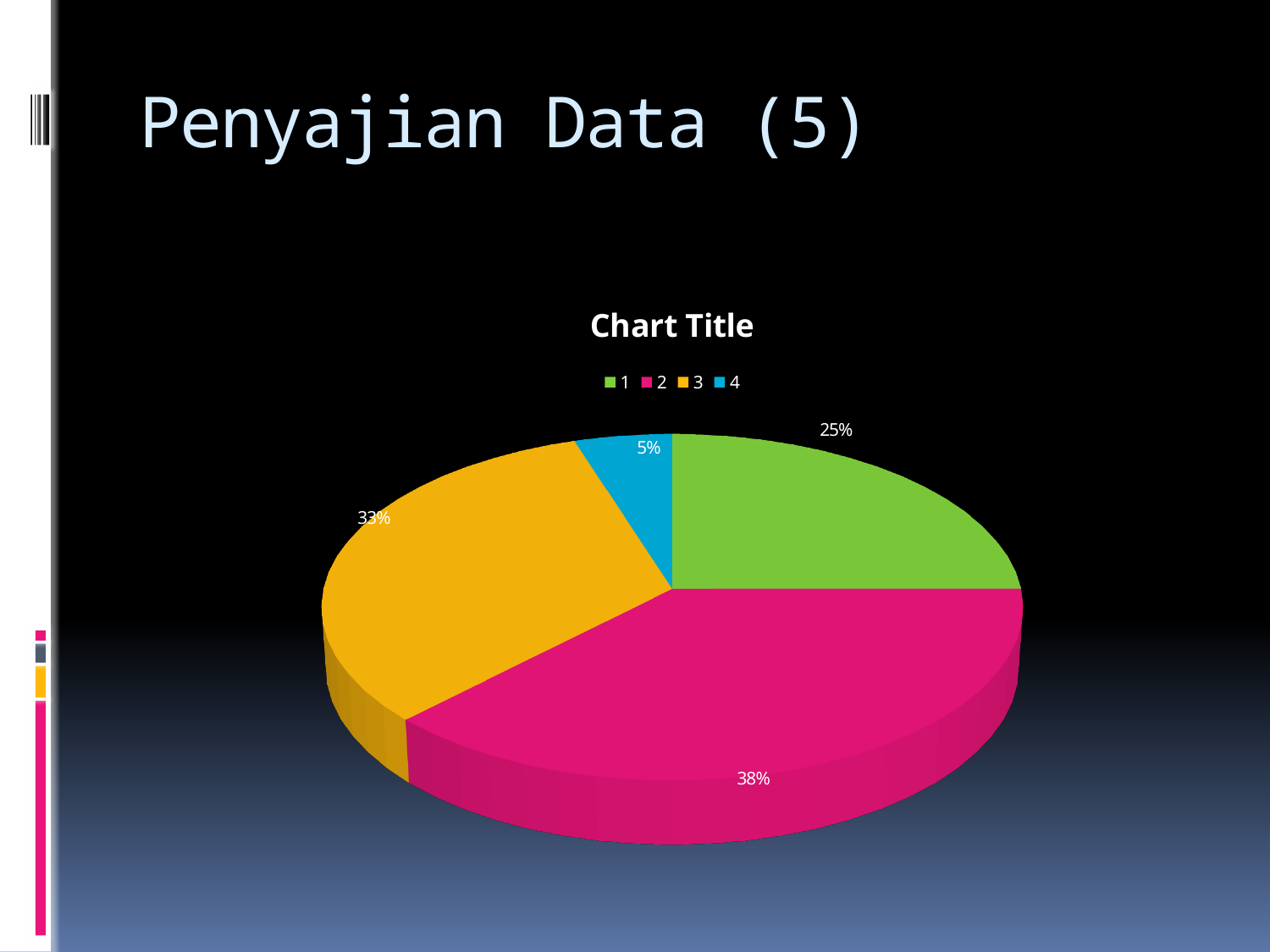
What percentage does category 4 represent in the pie chart? 5% What kind of chart is shown on the slide? pie chart What colour is the slice for category 4? blue What is the title of the chart? Chart Title Which category has the largest share of the pie chart? 2 Which is larger, the share of category 1 or the share of category 3? 3 What percentage does category 2 represent in the pie chart? 38% What percentage does category 1 represent in the pie chart? 25% How many slices does the pie chart have? 4 What percentage does category 3 represent in the pie chart? 33% What is the difference in percentage points between category 2 and category 1? 13 Which category has the smallest share of the pie chart? 4